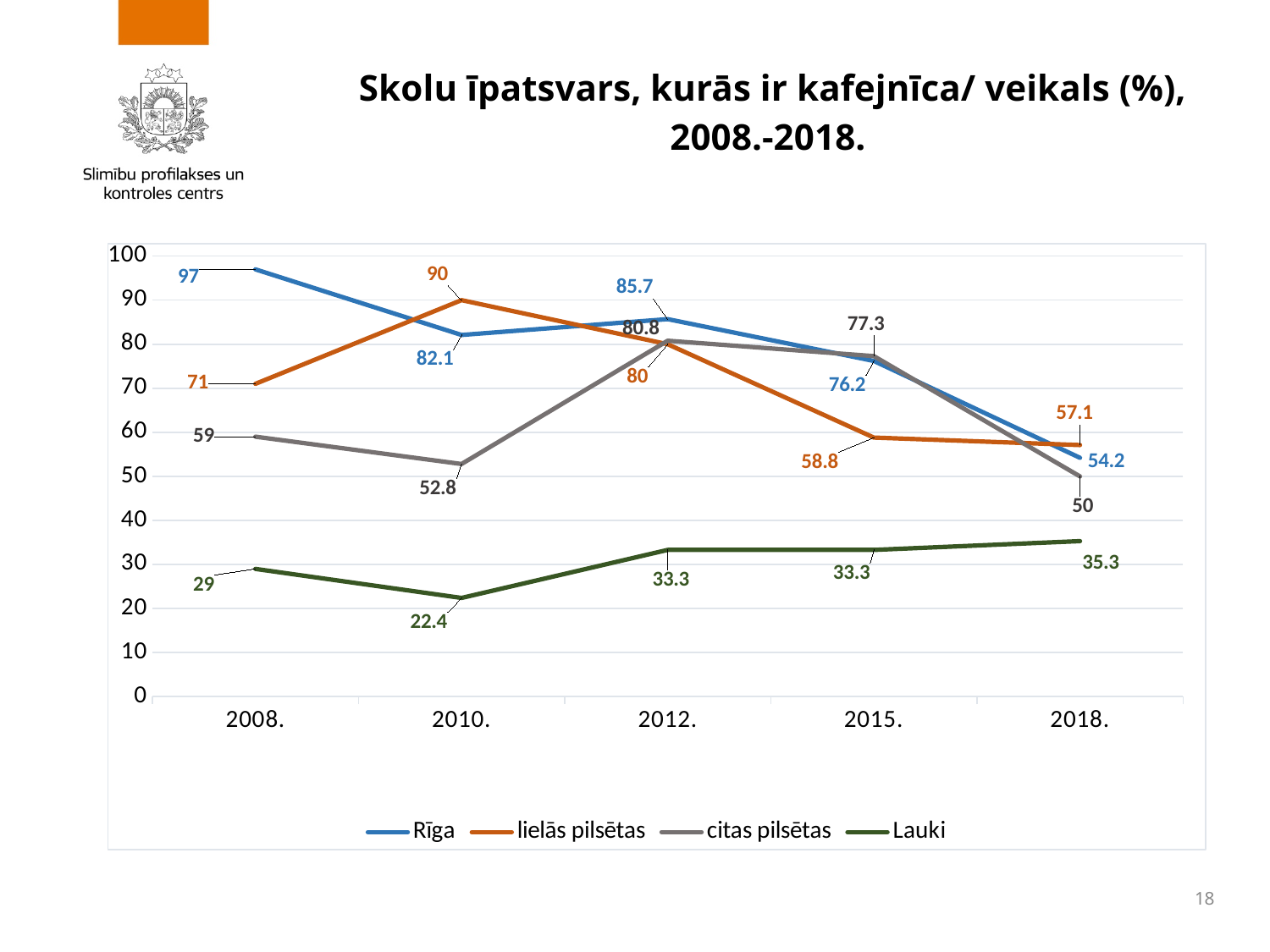
In which year is the value for Lauki lowest? 2010. What is the value for Lauki in 2018? 35.3 What type of chart is shown on the slide? line chart How many years are shown on the x axis? 5 What is the value for lielās pilsētas in 2010? 90 What is the difference between the Rīga value in 2008 and in 2018? 42.8 How many series does the legend list? 4 Does the value for Rīga rise or fall from 2012 to 2018? fall Which is larger in 2018, the value for lielās pilsētas or the value for citas pilsētas? lielās pilsētas What is the value for Rīga in 2008? 97 What is the value for citas pilsētas in 2015? 77.3 In which year is the value for Rīga highest? 2008.